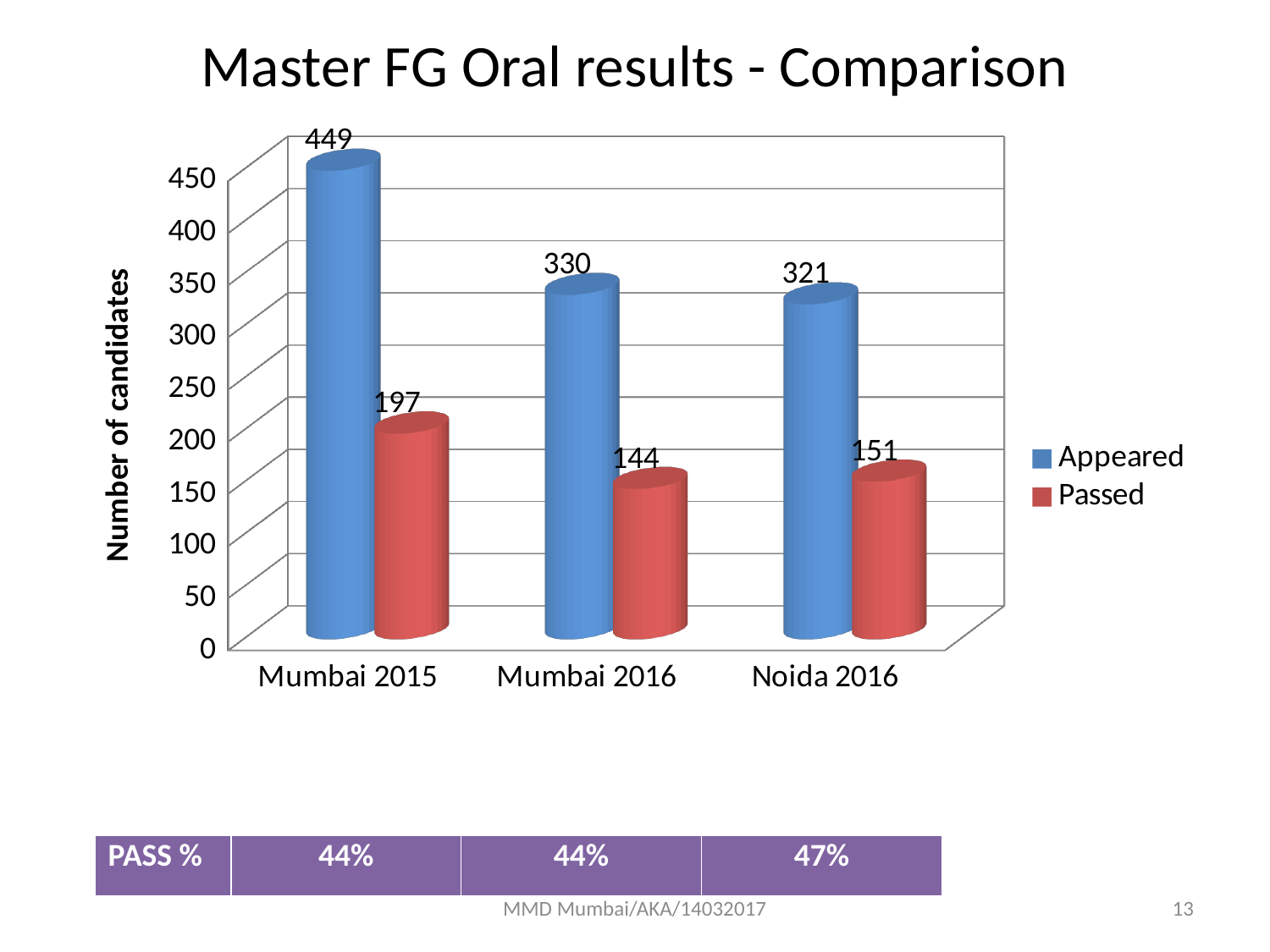
How many series does the legend list? 2 What is the Passed value for Noida 2016? 151 What is the difference between the Appeared values for Mumbai 2016 and Noida 2016? 9 Which is larger: the Passed value for Mumbai 2015 or the Passed value for Noida 2016? Mumbai 2015 How many categories are shown on the x axis? 3 How many candidates appeared in Mumbai 2015? 449 Which category has the highest number of candidates appeared? Mumbai 2015 What is the label of the vertical axis? Number of candidates Which category has the lowest number of candidates passed? Mumbai 2016 How many candidates passed in Mumbai 2016? 144 What is the difference between the number appeared and the number passed in Mumbai 2015? 252 What kind of chart is shown on the slide? Bar chart